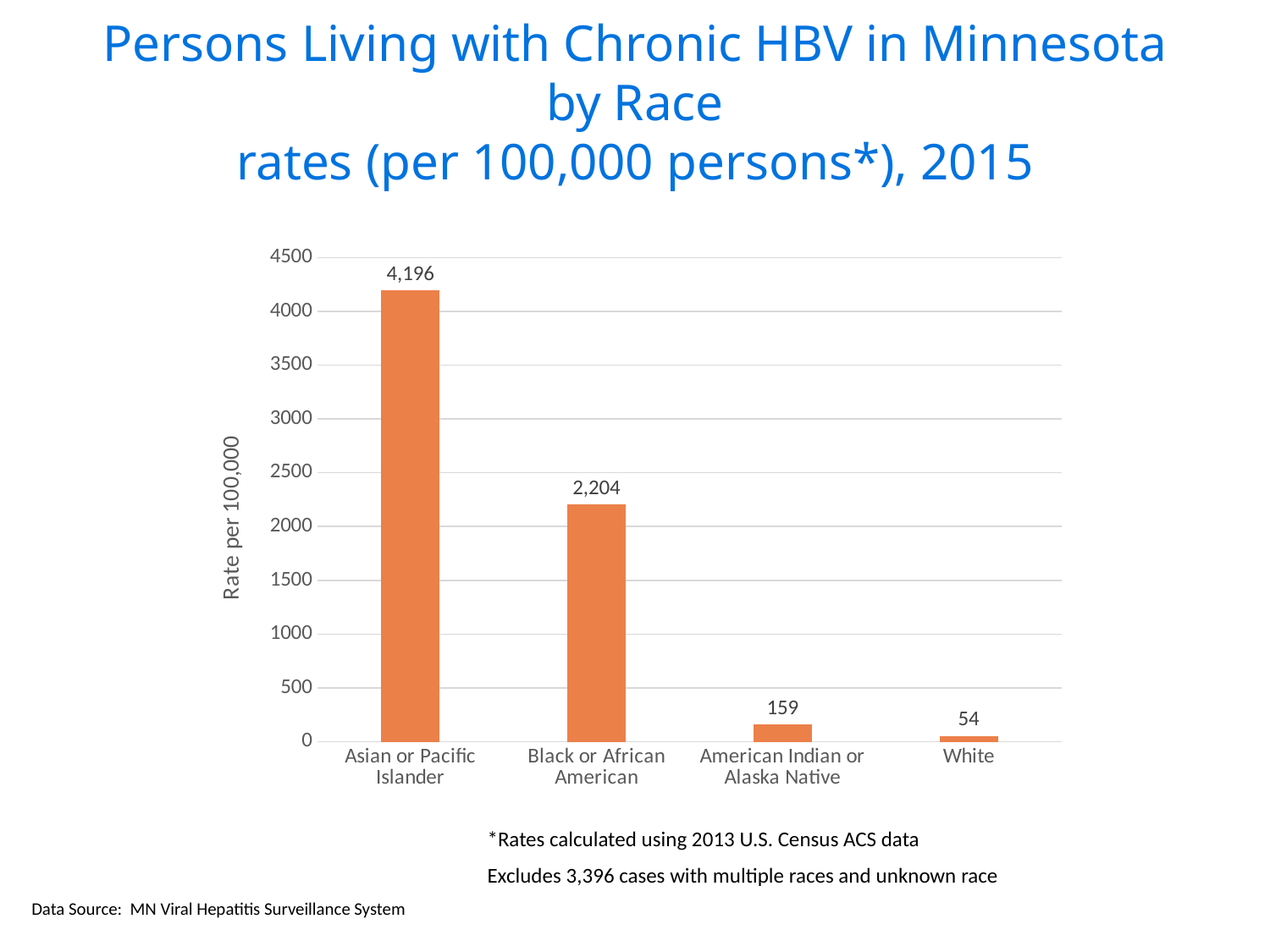
Which race group has the highest rate? Asian or Pacific Islander What is the rate per 100,000 for Asian or Pacific Islander? 4,196 What is the difference between the rates for American Indian or Alaska Native and White? 105 What kind of chart is shown on the slide? Bar chart What is the rate per 100,000 for White? 54 What is the rate per 100,000 for American Indian or Alaska Native? 159 What is the difference between the rates for Asian or Pacific Islander and Black or African American? 1,992 How many race categories are shown on the chart? 4 Which race group has the lowest rate? White What is the rate per 100,000 for Black or African American? 2,204 What is the label of the vertical axis? Rate per 100,000 Which has a higher rate, Black or African American or American Indian or Alaska Native? Black or African American